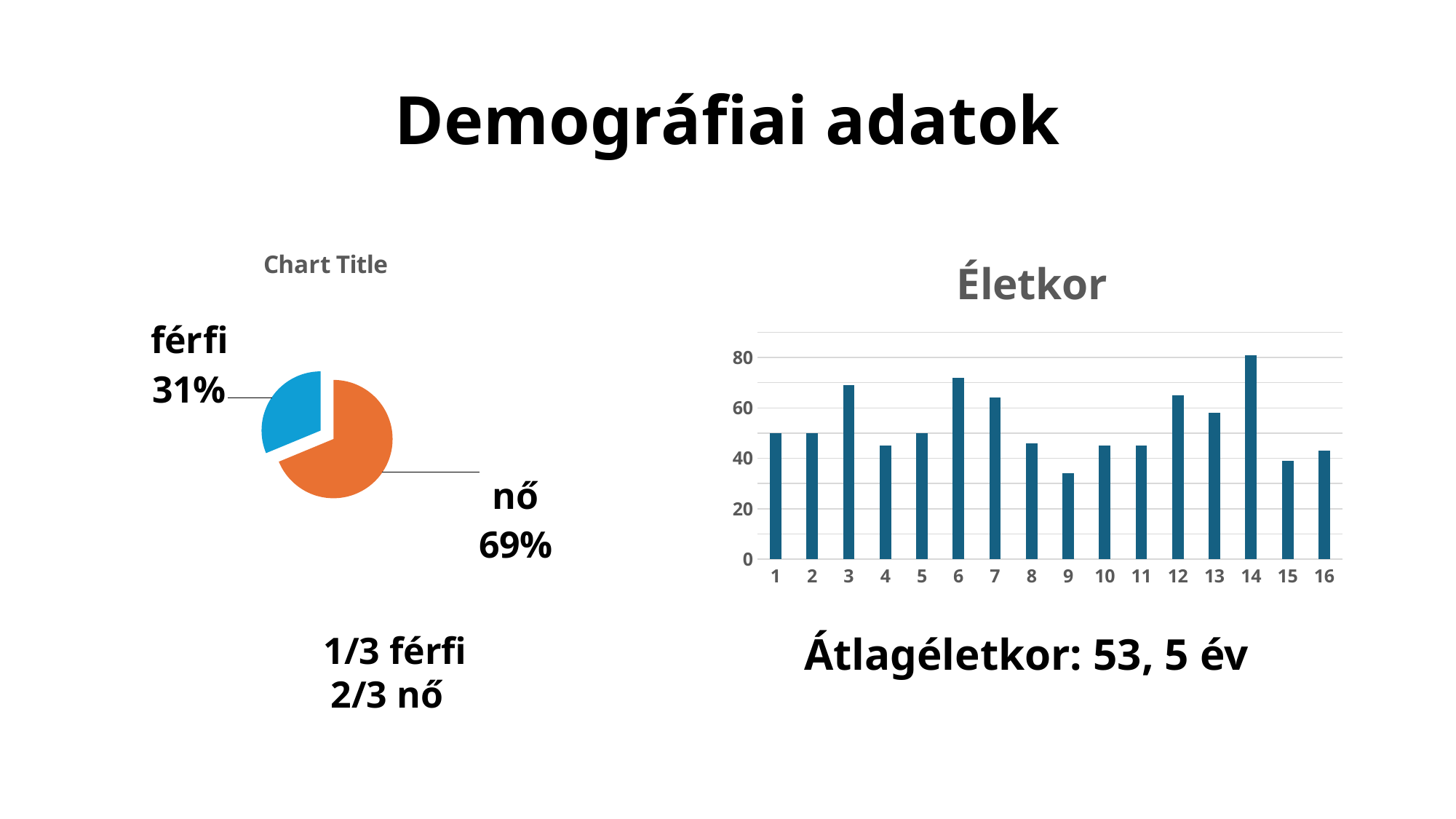
On the pie chart on the left, what is the difference in percentage points between the nő and férfi slices? 38 On the Életkor chart, which category has the highest bar? 14 On the pie chart on the left, which slice is larger, férfi or nő? nő What type of chart is the Életkor chart? bar chart On the pie chart on the left, what percentage is labelled for férfi? 31% On the pie chart on the left, how many slices does the pie have? 2 On the Életkor chart, which category has the lowest bar? 9 On the pie chart on the left, what percentage is labelled for nő? 69% What type of chart is the chart on the left of the slide? pie chart On the Életkor chart, how many bars are plotted? 16 On the Életkor chart, is the value for category 6 greater or less than 60? greater On the Életkor chart, which is larger, the value for category 3 or category 4? 3